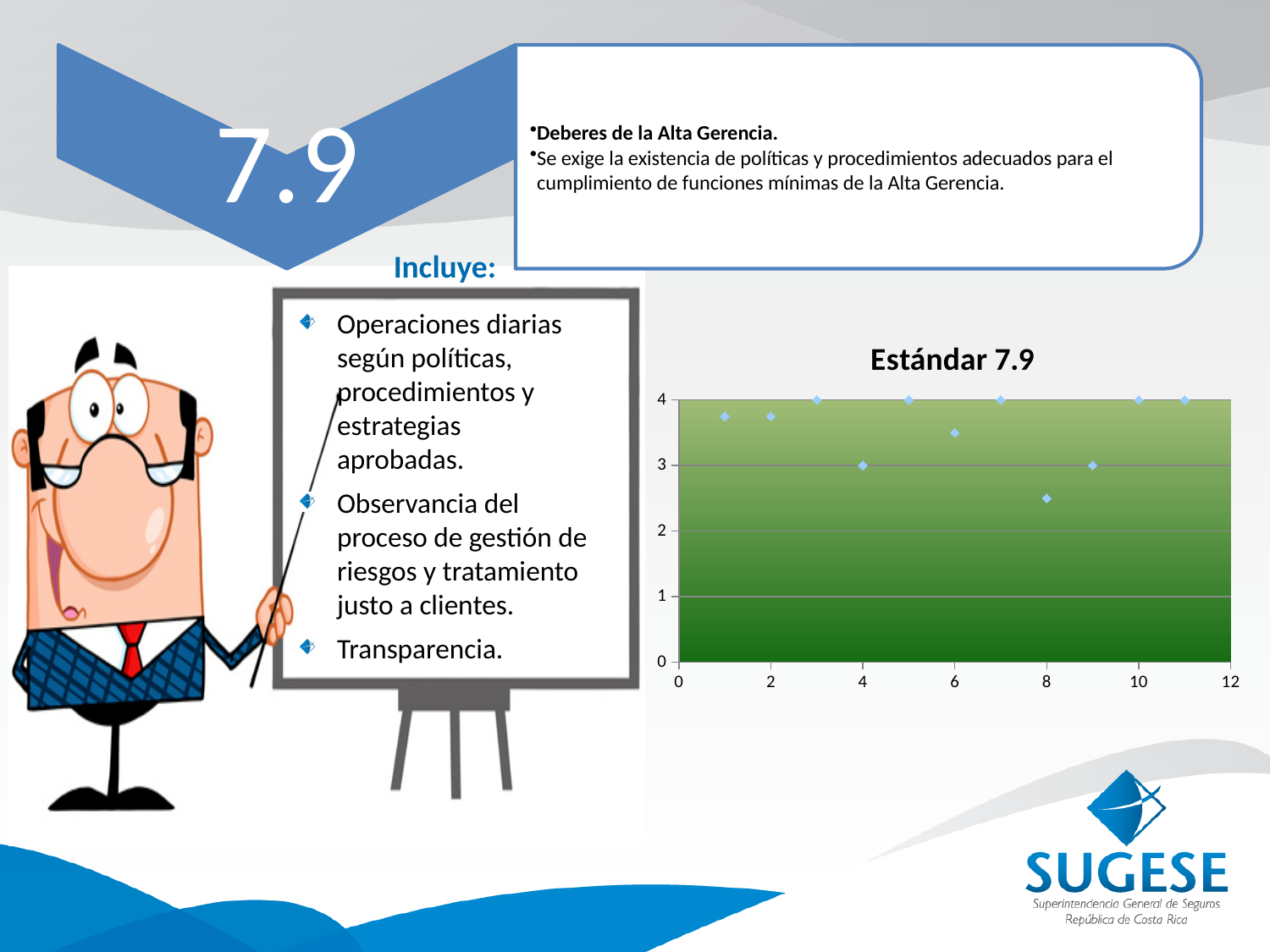
How many data points are plotted in the chart? 11 What is the title of the chart? Estándar 7.9 What kind of chart is shown on the slide? Scatter chart Is the y value of the point at x = 6 greater or less than 3? greater Which point has the larger y value, the one at x = 4 or the one at x = 8? x = 4 What is the y value of the point at x = 3? 4 What is the y value of the point at x = 11? 4 Is the y value of the point at x = 1 greater or less than 3? greater Is the y value of the point at x = 8 greater or less than 3? less What is the y value of the point at x = 4? 3 What is the y value of the point at x = 9? 3 At which x value does the lowest point occur? 8